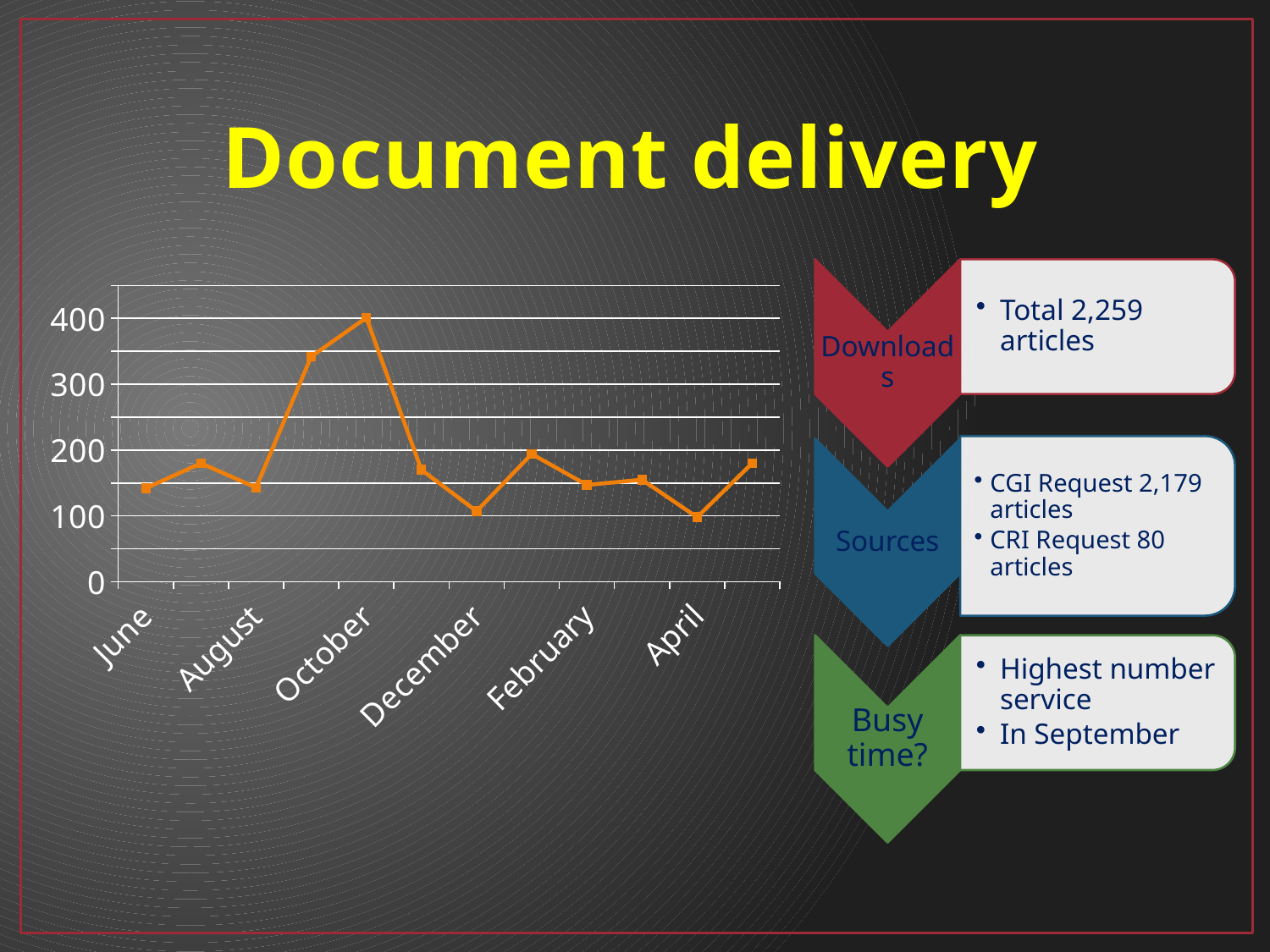
Is the value for August greater or less than 100? greater Is the value for June greater or less than 200? less Is the value for October greater or less than 300? greater Which month has the highest value on the line chart? October Which is larger, the value for October or the value for June? October How many data points are plotted on the line chart? 12 Do the values rise or fall from August to October? rise What colour is the line on the chart? orange What kind of chart is shown on the slide? line chart